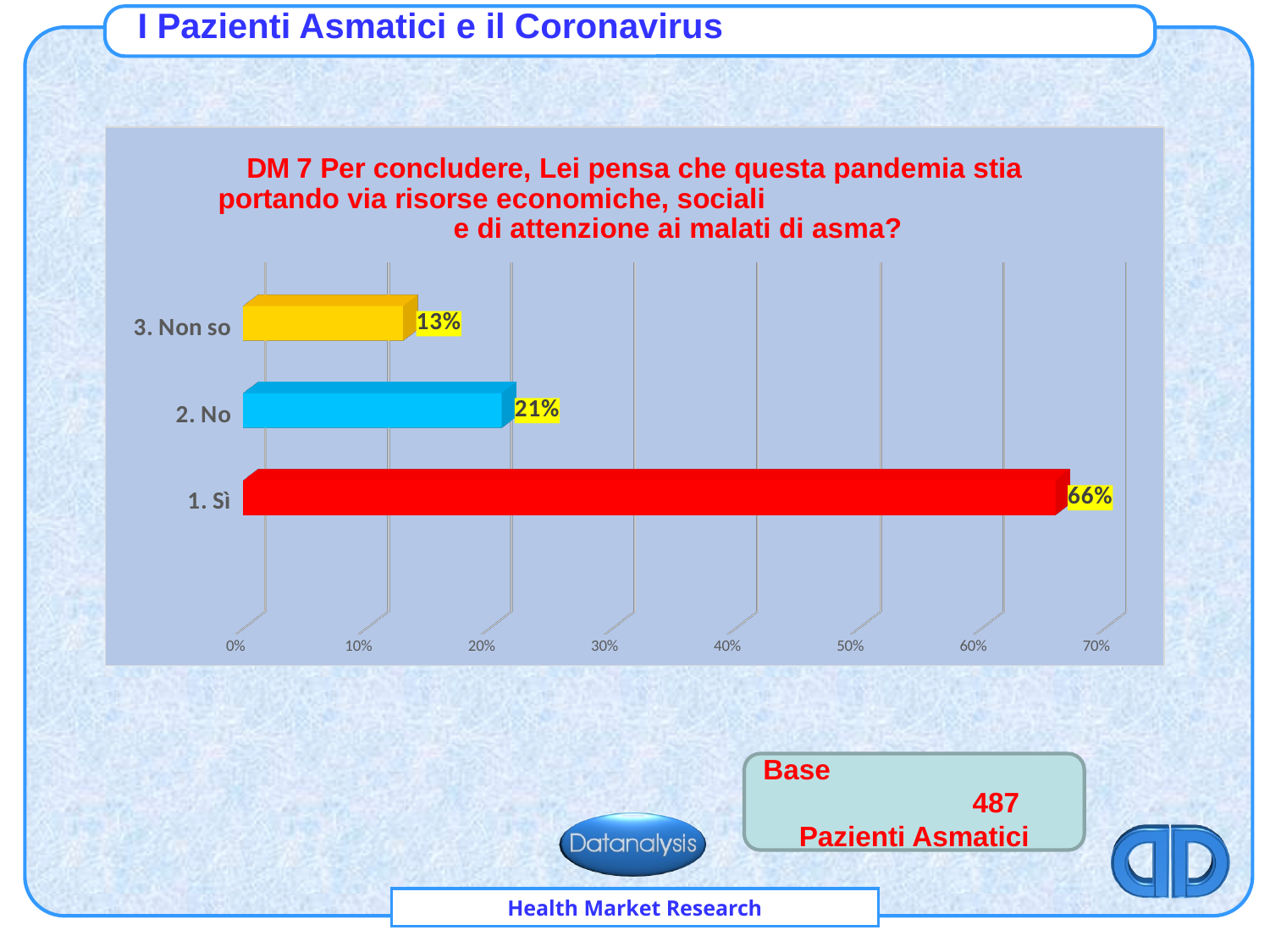
Which category has the lowest value? 3. Non so What is the value for "2. No"? 21% What is the difference between the values for "2. No" and "3. Non so"? 8% Is the value for "1. Sì" greater or less than 60%? greater What kind of chart is shown on the slide? bar chart What is the value for "1. Sì"? 66% What is the difference between the values for "1. Sì" and "2. No"? 45% Which category has the highest value? 1. Sì What colour is the bar for "1. Sì"? red Which is larger, the value for "2. No" or the value for "3. Non so"? 2. No What is the value for "3. Non so"? 13% How many categories are shown in the chart? 3